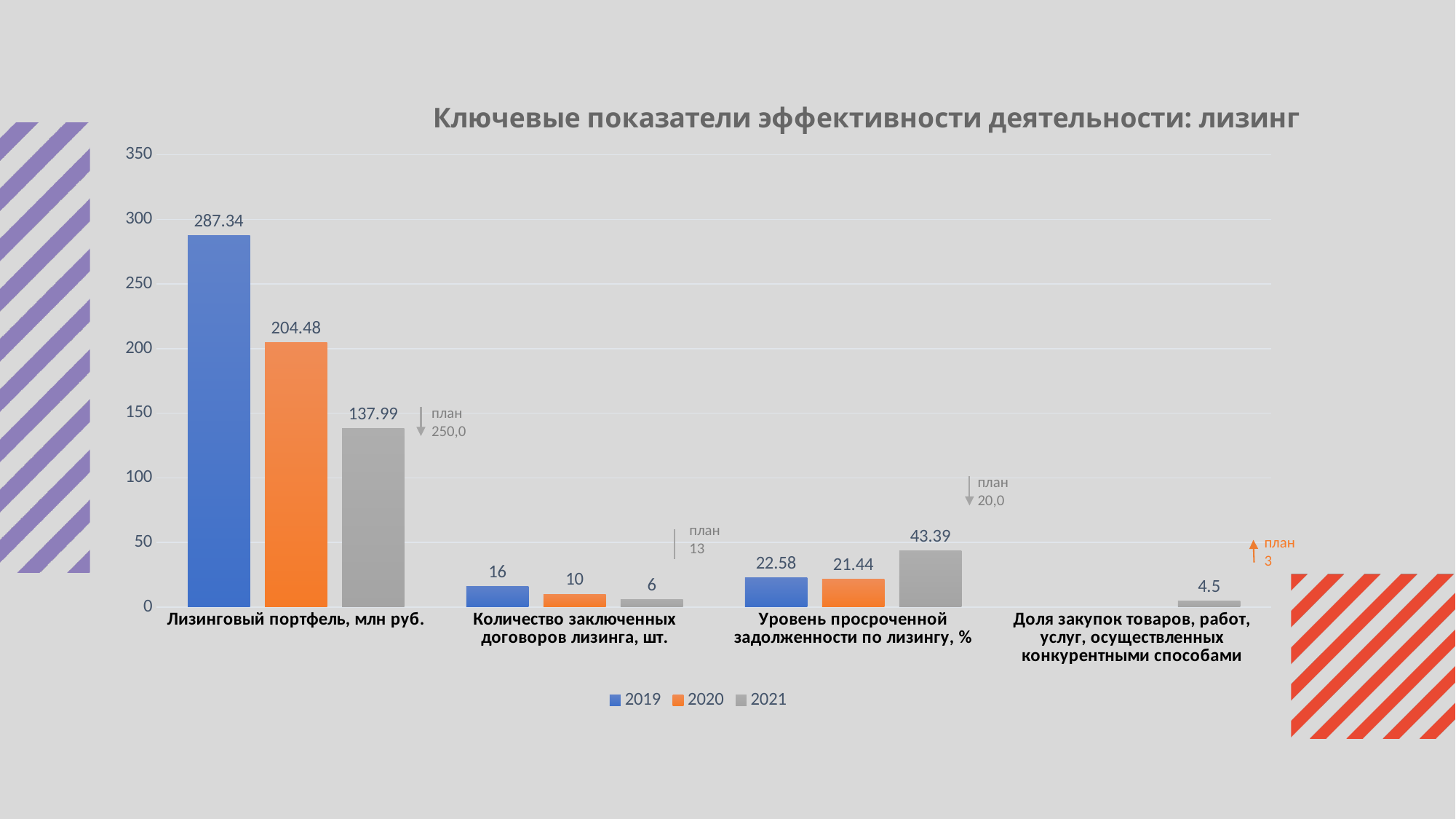
Which year has the lowest value in the category "Количество заключенных договоров лизинга, шт."? 2021 What is the value for 2019 in the category "Лизинговый портфель, млн руб."? 287.34 Is the 2021 value for "Лизинговый портфель, млн руб." greater or less than 150? less Which is larger in the category "Уровень просроченной задолженности по лизингу, %": the 2019 value or the 2021 value? 2021 What kind of chart is shown on the slide? bar chart What is the value for 2021 in the category "Уровень просроченной задолженности по лизингу, %"? 43.39 How many series does the legend list? 3 How many categories are shown on the x axis of the chart? 4 What is the value for 2021 in the category "Доля закупок товаров, работ, услуг, осуществленных конкурентными способами"? 4.5 Which year has the highest value in the category "Лизинговый портфель, млн руб."? 2019 What is the value for 2020 in the category "Количество заключенных договоров лизинга, шт."? 10 What is the difference between the 2019 and 2020 values in the category "Лизинговый портфель, млн руб."? 82.86